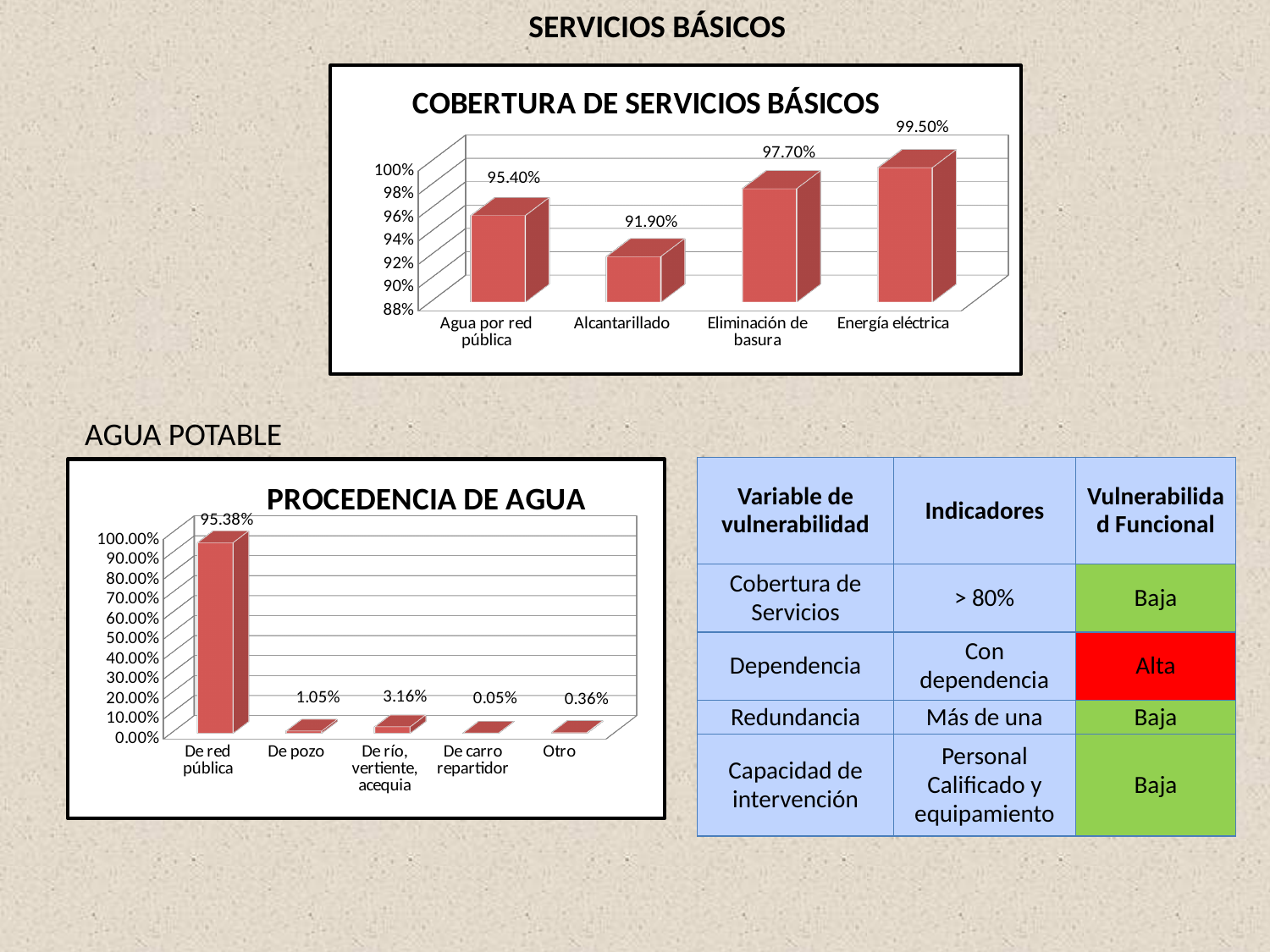
In the 'PROCEDENCIA DE AGUA' chart, what is the value for De río, vertiente, acequia? 3.16% In the 'PROCEDENCIA DE AGUA' chart, how many categories are shown? 5 In the 'PROCEDENCIA DE AGUA' chart, which category has the lowest value? De carro repartidor In the 'COBERTURA DE SERVICIOS BÁSICOS' chart, how many categories are shown? 4 In the 'PROCEDENCIA DE AGUA' chart, what is the value for De red pública? 95.38% In the 'COBERTURA DE SERVICIOS BÁSICOS' chart, what is the value for Alcantarillado? 91.90% What kind of chart is 'PROCEDENCIA DE AGUA'? Bar chart In the 'COBERTURA DE SERVICIOS BÁSICOS' chart, which category has the highest value? Energía eléctrica In the 'COBERTURA DE SERVICIOS BÁSICOS' chart, what is the value for Energía eléctrica? 99.50% In the 'COBERTURA DE SERVICIOS BÁSICOS' chart, which category has the lowest value? Alcantarillado In the 'COBERTURA DE SERVICIOS BÁSICOS' chart, what is the difference between Energía eléctrica and Agua por red pública? 4.10% In the 'PROCEDENCIA DE AGUA' chart, which is larger: De pozo or Otro? De pozo